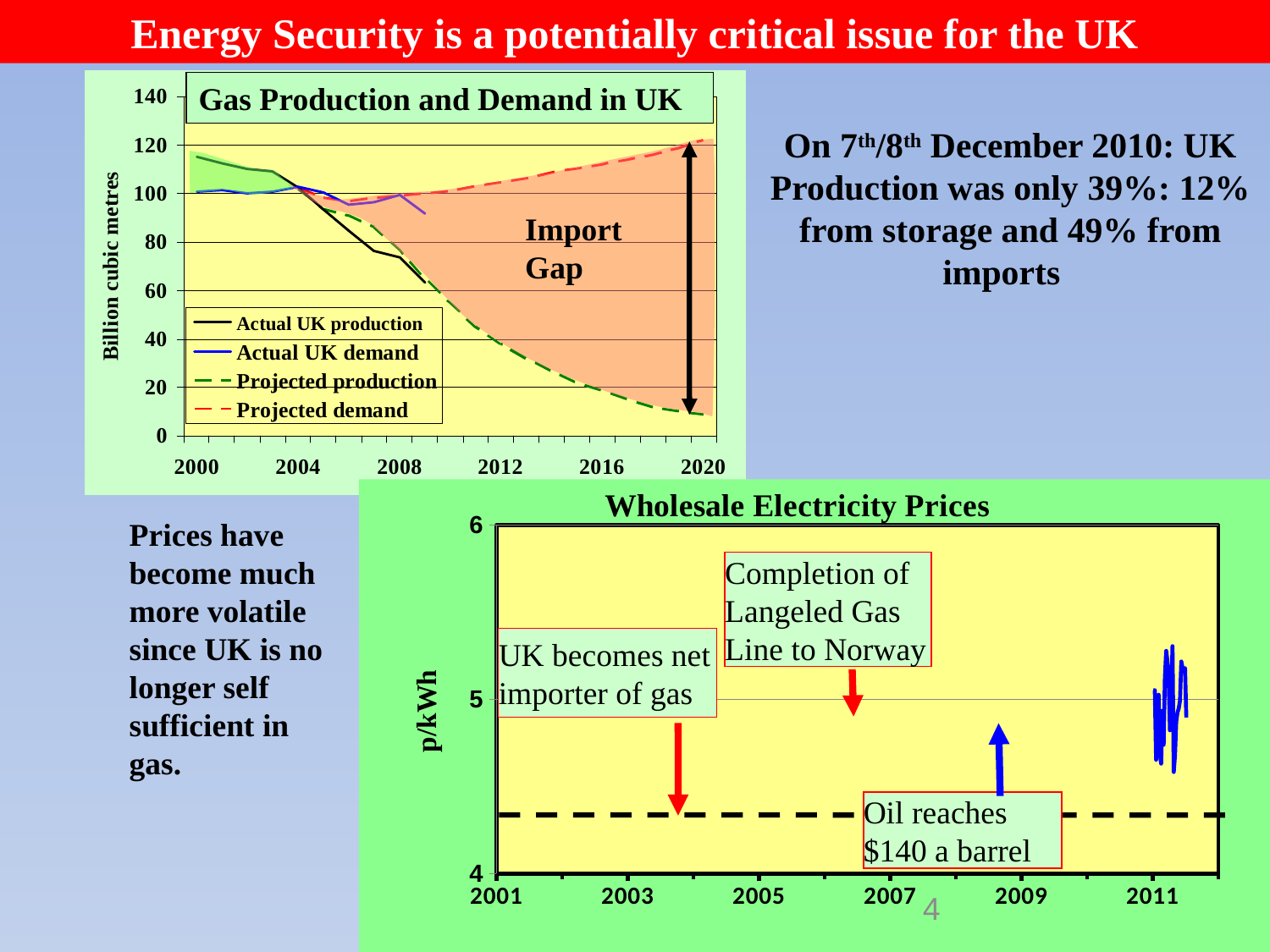
In the 'Gas Production and Demand in UK' chart, what is the label of the y axis? Billion cubic metres In the 'Gas Production and Demand in UK' chart, is the projected production value in 2020 greater or less than 20? less In the 'Gas Production and Demand in UK' chart, is the actual UK production value in 2000 greater or less than 100? greater In the 'Gas Production and Demand in UK' chart, how many year labels are shown on the x axis? 6 In the 'Gas Production and Demand in UK' chart, is the projected demand value in 2020 greater or less than 100? greater What kind of chart is the 'Wholesale Electricity Prices' chart? line chart In the 'Gas Production and Demand in UK' chart, does the projected demand line rise or fall between 2008 and 2020? rise In the 'Gas Production and Demand in UK' chart, how many series does the legend list? 4 In the 'Gas Production and Demand in UK' chart, in 2020, which is larger: projected demand or projected production? projected demand In the 'Gas Production and Demand in UK' chart, does the projected production line rise or fall between 2008 and 2020? fall In the 'Wholesale Electricity Prices' chart, what unit is shown on the y axis? p/kWh